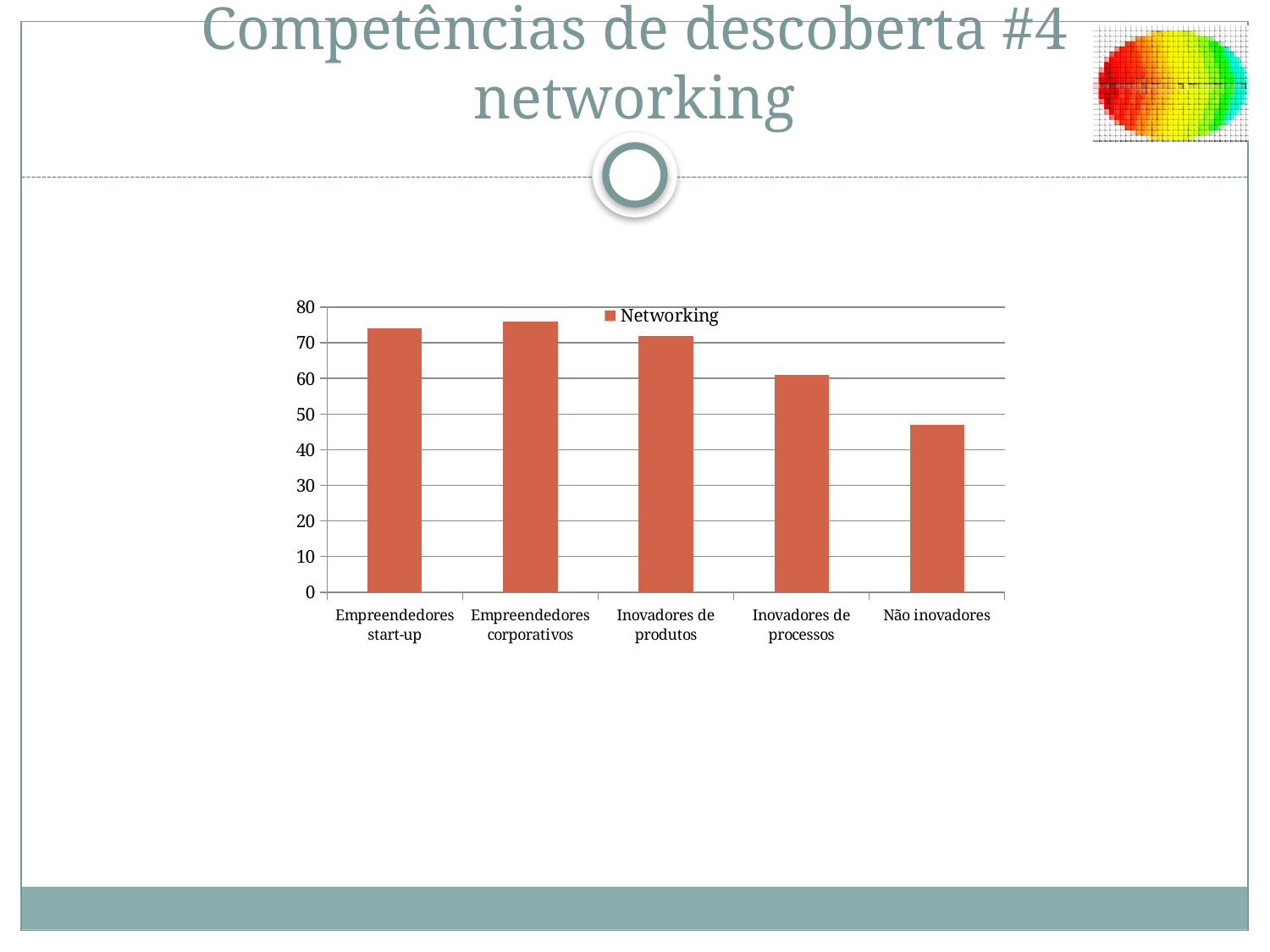
What kind of chart is shown on the slide? bar chart Which category has the lowest value in the chart? Não inovadores Do the values generally rise or fall from left to right across the categories? fall How many categories are shown on the x axis of the chart? 5 Which is larger, the value for Inovadores de produtos or the value for Não inovadores? Inovadores de produtos Is the value for Inovadores de processos greater or less than 70? less Which is larger, the value for Empreendedores start-up or the value for Inovadores de processos? Empreendedores start-up How many series does the chart legend list? 1 Is the value for Não inovadores greater or less than 50? less Is the value for Empreendedores start-up greater or less than 70? greater What is the name of the series shown in the chart legend? Networking